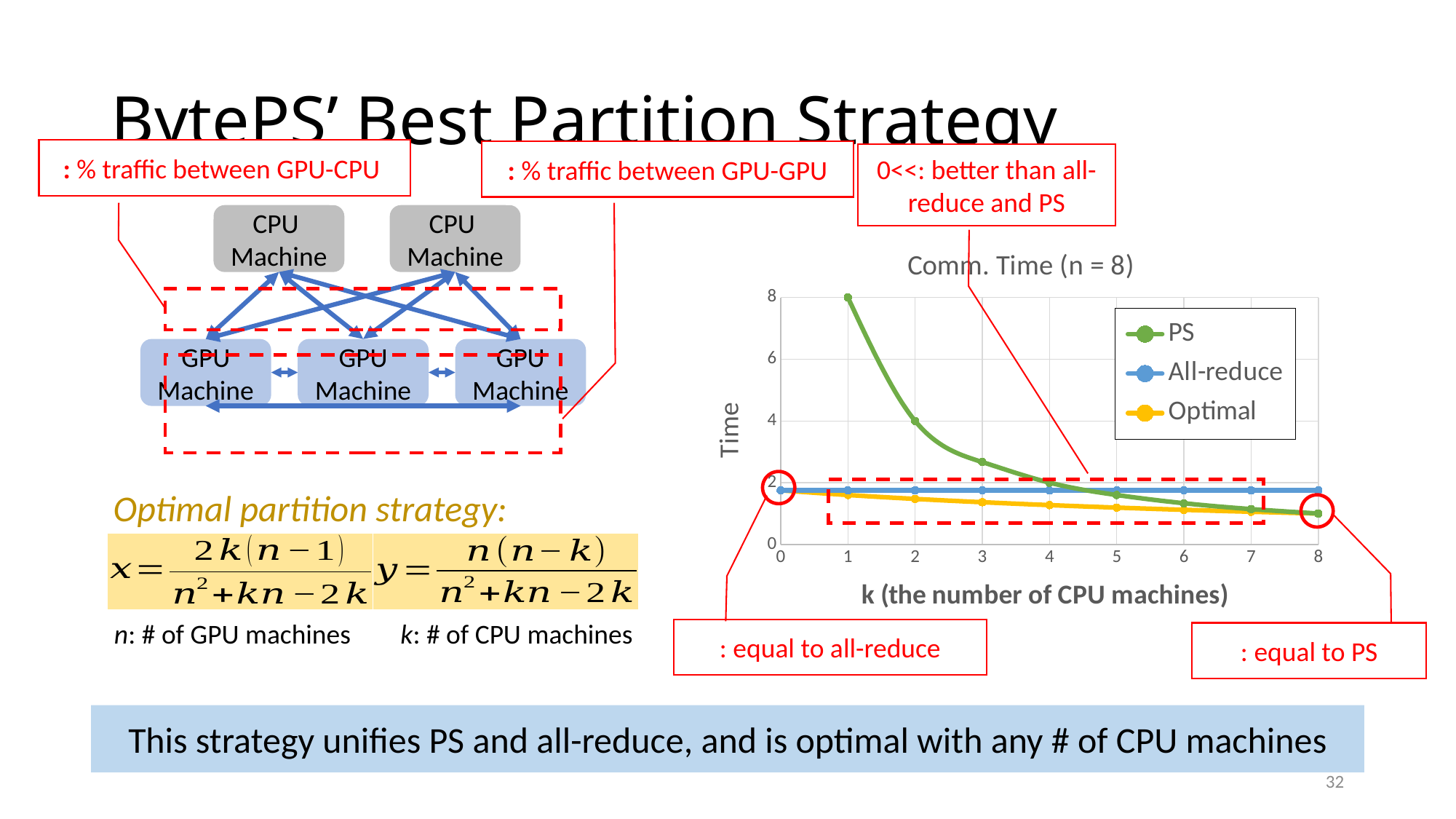
What kind of chart is shown on the slide? line chart How many series does the chart legend list? 3 What is the label of the x axis of the chart? k (the number of CPU machines) Does the PS series rise or fall as k increases? fall What is the value of the PS series at k = 2? 4 What is the value of the PS series at k = 1? 8 Is the value of the PS series at k = 3 greater or less than 2? greater At k = 2, which series has the larger value, PS or Optimal? PS Does the Optimal series rise or fall as k increases? fall What is the title of the chart? Comm. Time (n = 8) At which value of k does the PS series reach its highest value? 1 Is the value of the All-reduce series at k = 4 greater or less than 4? less